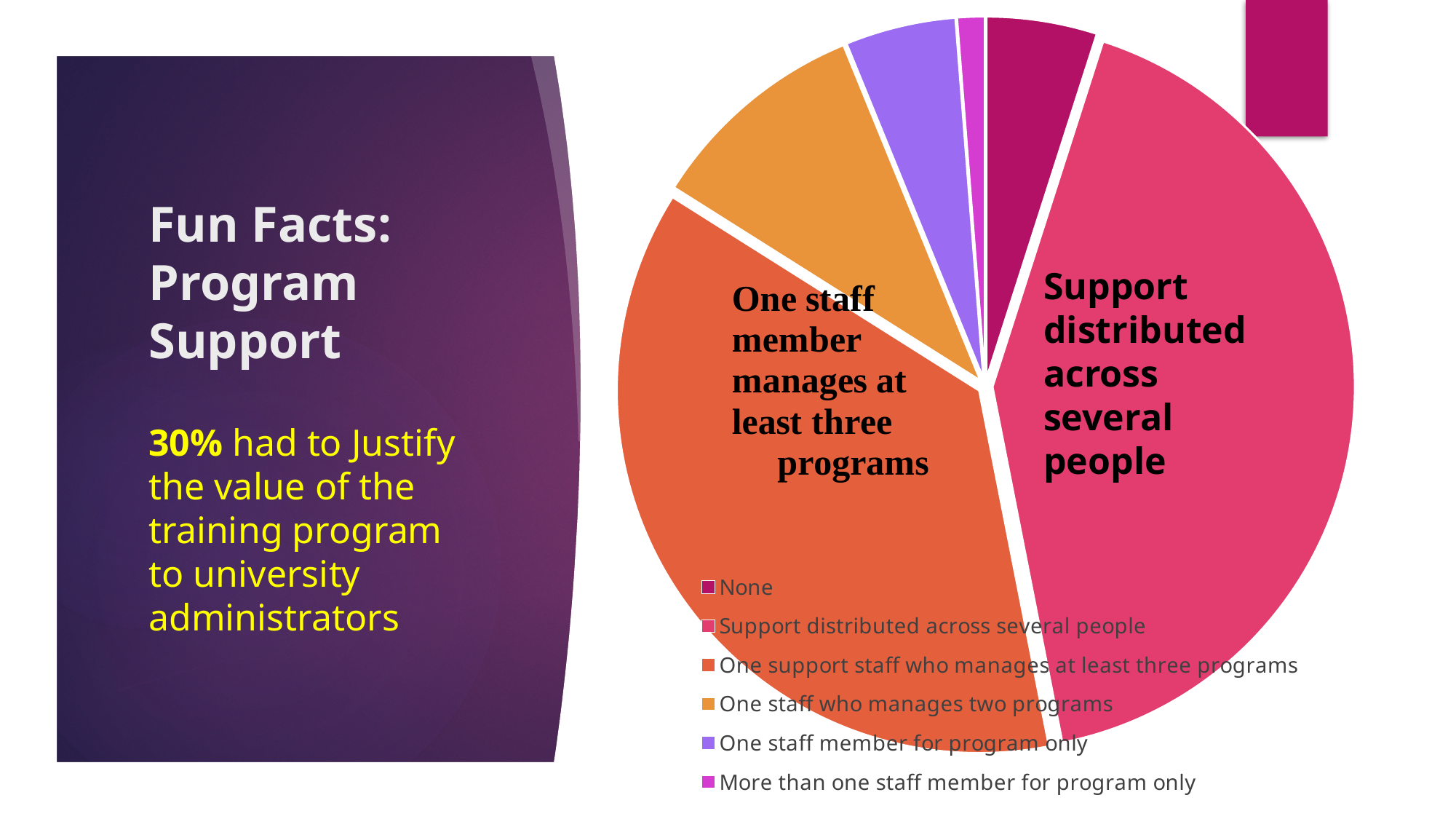
Which slice is larger: 'One staff who manages two programs' or 'One staff member for program only'? One staff who manages two programs What colour is the slice for 'One support staff who manages at least three programs'? orange Which slice is larger: 'One staff who manages two programs' or 'More than one staff member for program only'? One staff who manages two programs Which legend entry is listed first in the pie chart's legend? None Which slice is larger: 'Support distributed across several people' or 'One support staff who manages at least three programs'? Support distributed across several people What kind of chart is shown on the slide? pie chart Which category has the largest slice of the pie chart? Support distributed across several people Which category has the smallest slice of the pie chart? More than one staff member for program only How many entries does the legend of the pie chart list? 6 How many slices does the pie chart have? 6